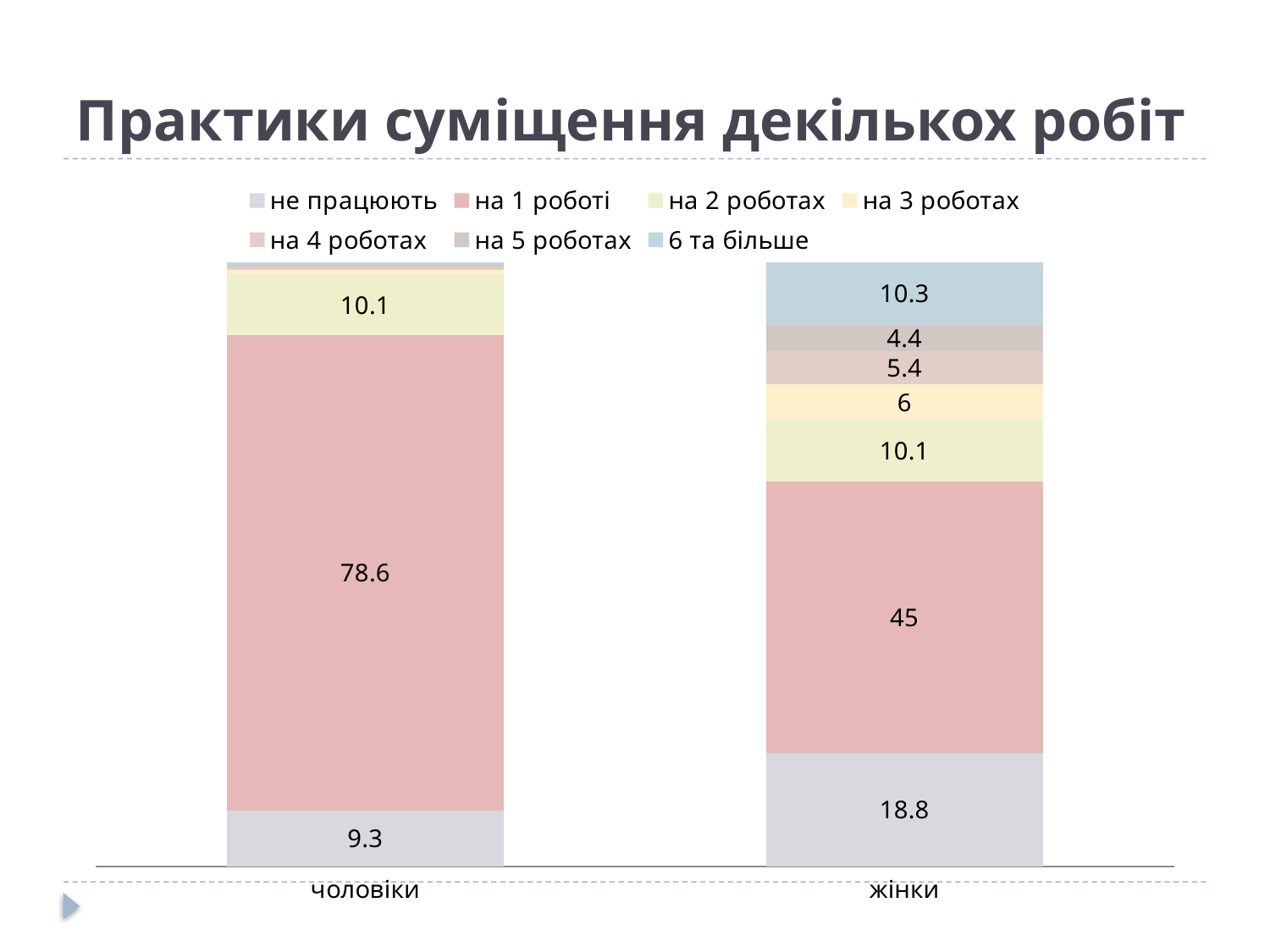
What kind of chart is shown on the slide? stacked bar chart What is the total of the stacked bar for жінки? 100 How many series does the legend list? 7 What is the difference between the "на 1 роботі" values for чоловіки and жінки? 33.6 What is the value of the "не працюють" segment for жінки? 18.8 Which category has the larger "не працюють" value, чоловіки or жінки? жінки What is the title of the chart on the slide? Практики суміщення декількох робіт What is the value of the "на 3 роботах" segment for жінки? 6 What is the value of the "на 1 роботі" segment for чоловіки? 78.6 What is the value of the "6 та більше" segment for жінки? 10.3 What is the value of the "на 5 роботах" segment for жінки? 4.4 How many categories are shown on the x axis? 2